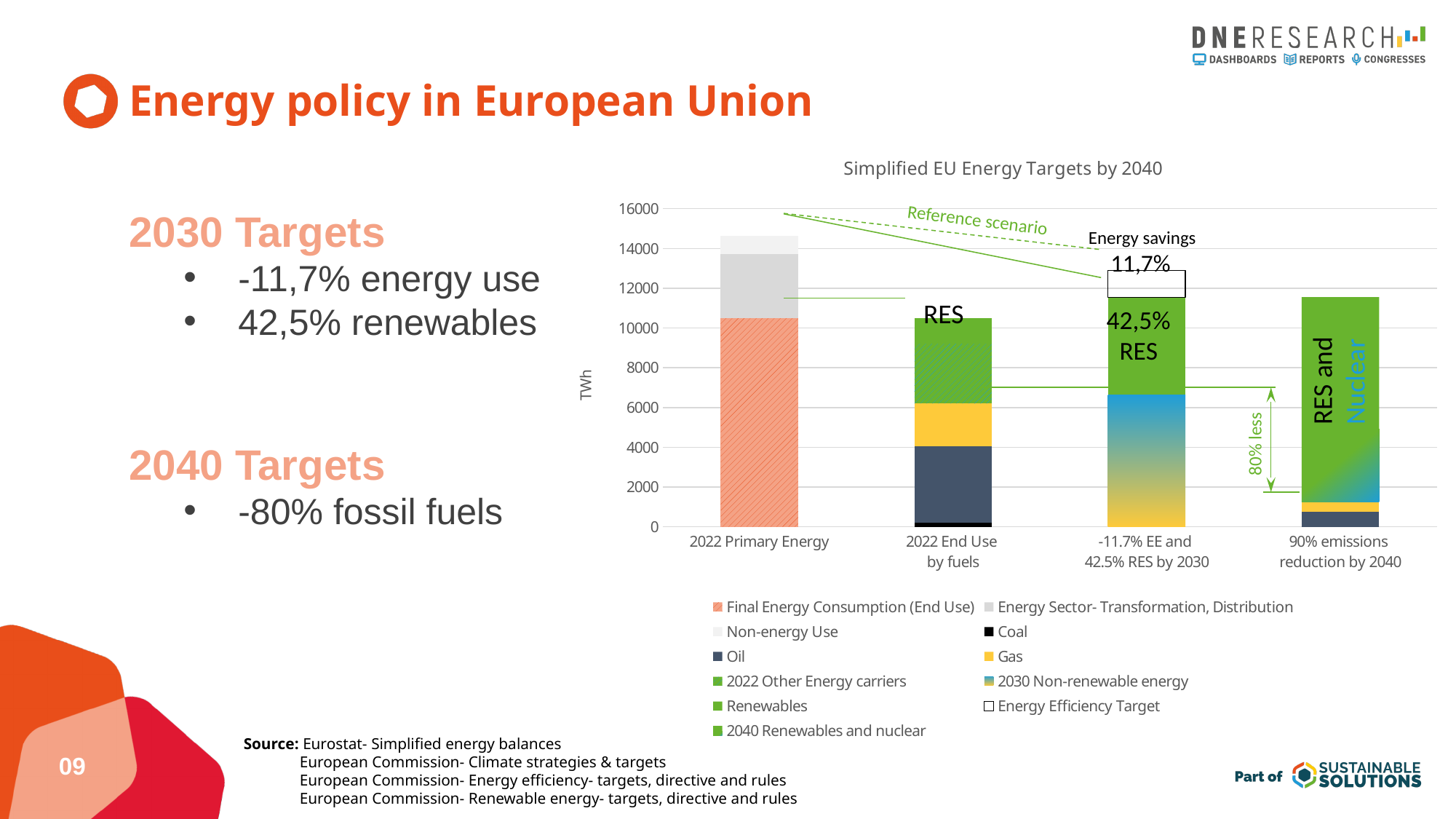
What is the title of the chart? Simplified EU Energy Targets by 2040 What kind of chart is shown on the slide? bar chart Which bar is taller: 2022 Primary Energy or 2022 End Use by fuels? 2022 Primary Energy How many categories are shown on the x axis of the chart? 4 What renewables share is labelled on the bar for -11.7% EE and 42.5% RES by 2030? 42,5% RES Is the total for 2022 Primary Energy greater or less than 14000 TWh? greater Which category has the tallest bar in the chart? 2022 Primary Energy How many series does the chart legend list? 11 Which category has the shortest bar in the chart? 2022 End Use by fuels What unit is shown on the y axis of the chart? TWh Is the Coal segment in the 2022 End Use by fuels bar greater or less than 2000 TWh? less Is the total for 2022 End Use by fuels greater or less than 12000 TWh? less